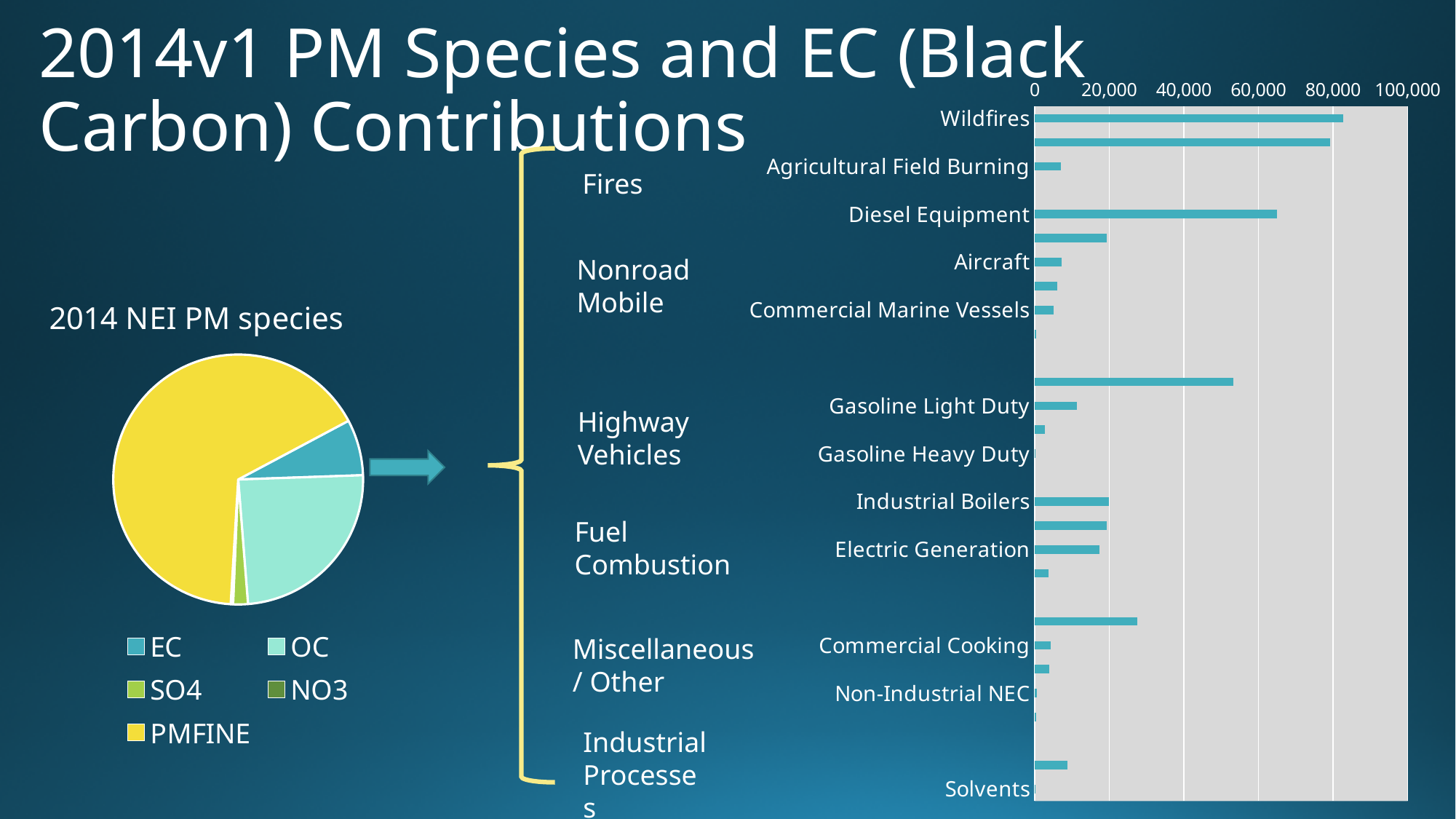
What is the highest value shown on the axis of the bar chart on the right? 100,000 In the bar chart on the right, is the value for Diesel Equipment greater or less than 60,000? greater What kind of chart is the chart on the left of the slide? pie chart In the bar chart on the right, which is larger, Diesel Equipment or Aircraft? Diesel Equipment In the bar chart on the right, is the value for Gasoline Light Duty greater or less than 20,000? less In the bar chart on the right, is the value for Agricultural Field Burning greater or less than 20,000? less In the pie chart, which slice is larger, OC or EC? OC In the pie chart, which species has the largest slice? PMFINE What kind of chart is the chart on the right of the slide? bar chart In the pie chart, how many entries does the legend list? 5 What is the title of the pie chart? 2014 NEI PM species In the bar chart on the right, which labeled category has the longest bar? Wildfires